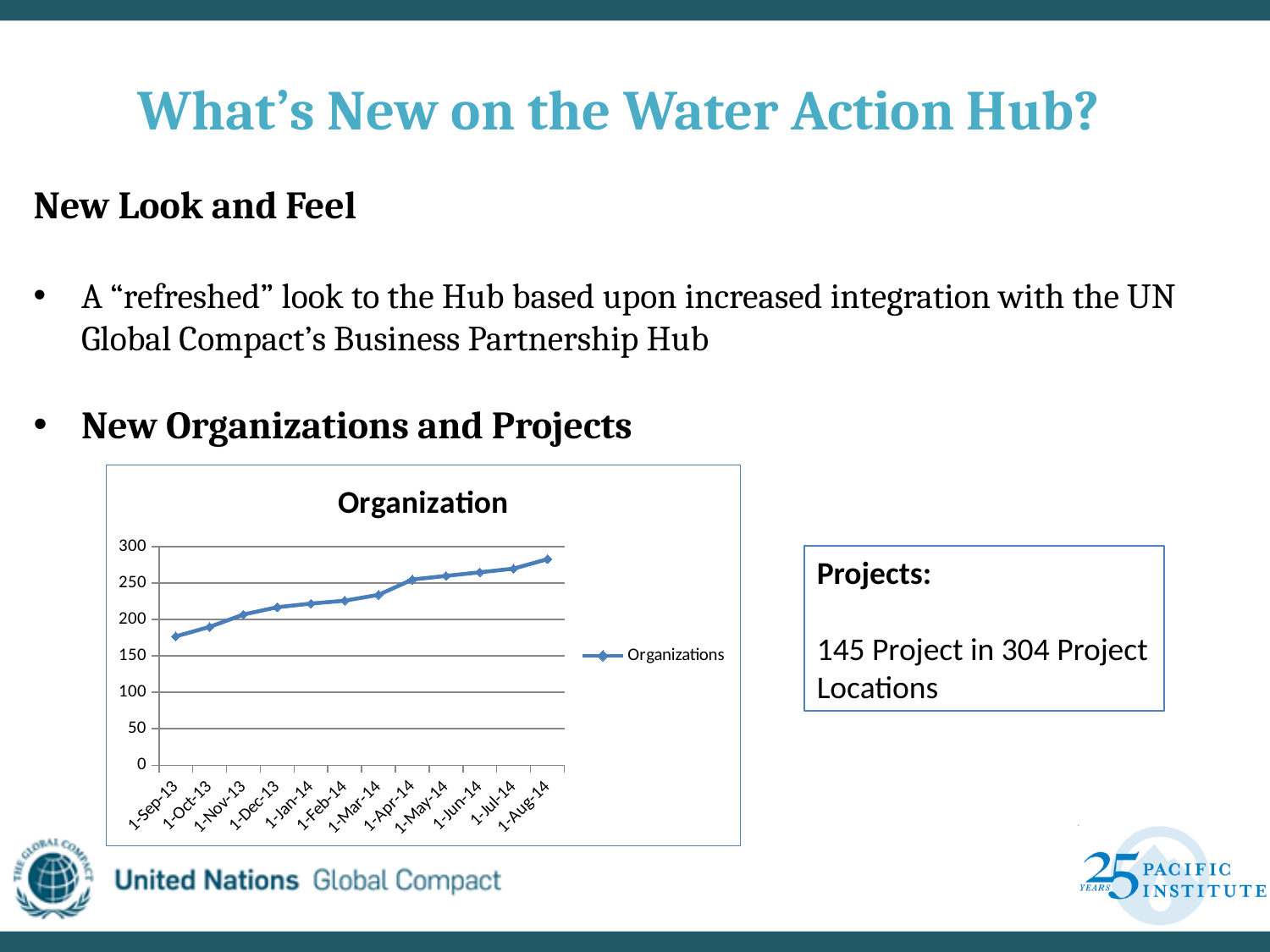
What is the name of the series shown in the legend? Organizations Is the value for Organizations on 1-Mar-14 greater or less than 250? less What kind of chart is shown on the slide? line chart Which is larger, the value for Organizations on 1-Aug-14 or on 1-Sep-13? 1-Aug-14 Is the value for Organizations on 1-Sep-13 greater or less than 200? less Do the values for Organizations rise or fall from 1-Sep-13 to 1-Aug-14? rise How many data points are plotted on the chart? 12 How many series does the chart's legend list? 1 What is the title of the chart? Organization Which date has the highest value for Organizations? 1-Aug-14 Is the value for Organizations on 1-Aug-14 greater or less than 250? greater Which date has the lowest value for Organizations? 1-Sep-13